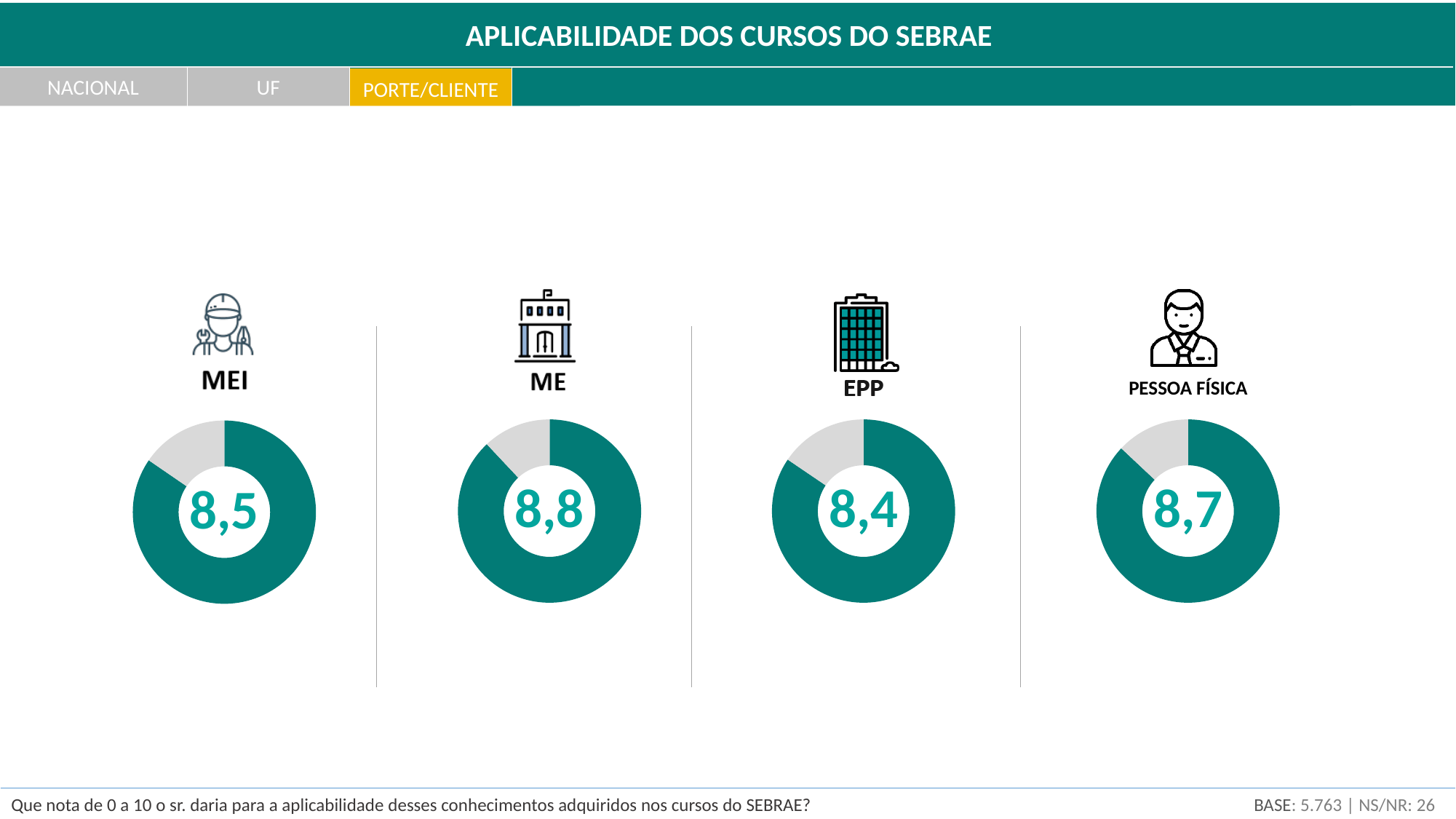
What score is shown in the PESSOA FÍSICA donut chart? 8,7 What score is shown in the ME donut chart? 8,8 How many donut charts are shown on the slide? 4 Which has a higher score, MEI or PESSOA FÍSICA? PESSOA FÍSICA What score is shown in the MEI donut chart? 8,5 What is the difference between the ME score and the EPP score? 0,4 Which segment has the lowest score among the four donut charts? EPP Which segment has the highest score among the four donut charts? ME What score is shown in the EPP donut chart? 8,4 What kind of chart is used to display each segment's score? Donut chart What is the difference between the PESSOA FÍSICA score and the MEI score? 0,2 What is the title of the slide? APLICABILIDADE DOS CURSOS DO SEBRAE